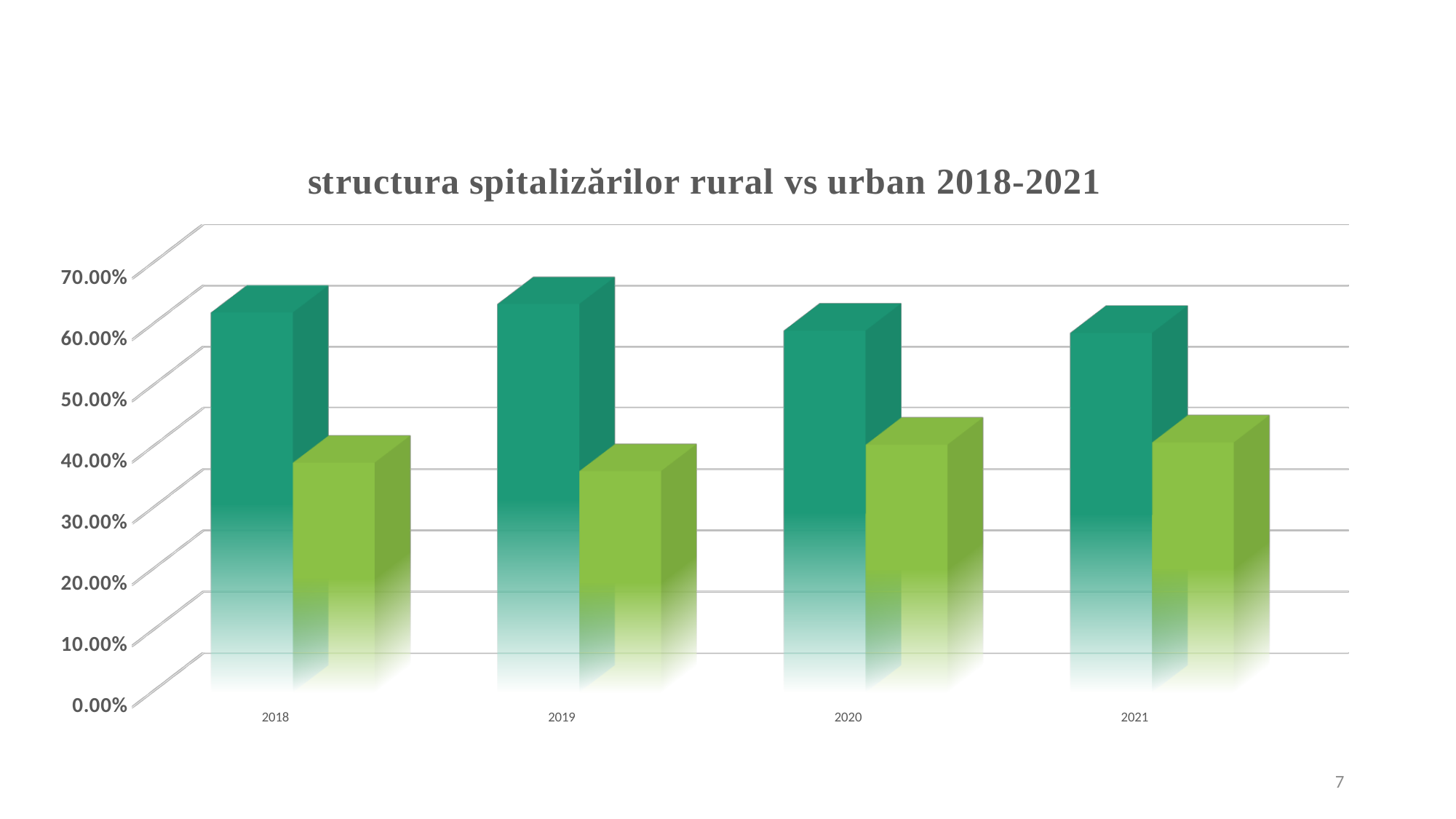
From 2019 to 2021, do the values of the dark teal series rise or fall? fall Is the value of the light green bar for 2020 greater or less than 50%? less Is the value of the dark teal bar for 2019 greater or less than 60%? greater What kind of chart is shown on the slide? bar chart What is the title of the chart? structura spitalizărilor rural vs urban 2018-2021 Is the value of the dark teal bar for 2018 greater or less than 60%? greater In 2020, which bar is taller, the dark teal one or the light green one? the dark teal one How many data series are plotted in the chart? 2 From 2019 to 2021, do the values of the light green series rise or fall? rise How many years are shown on the x axis of the chart? 4